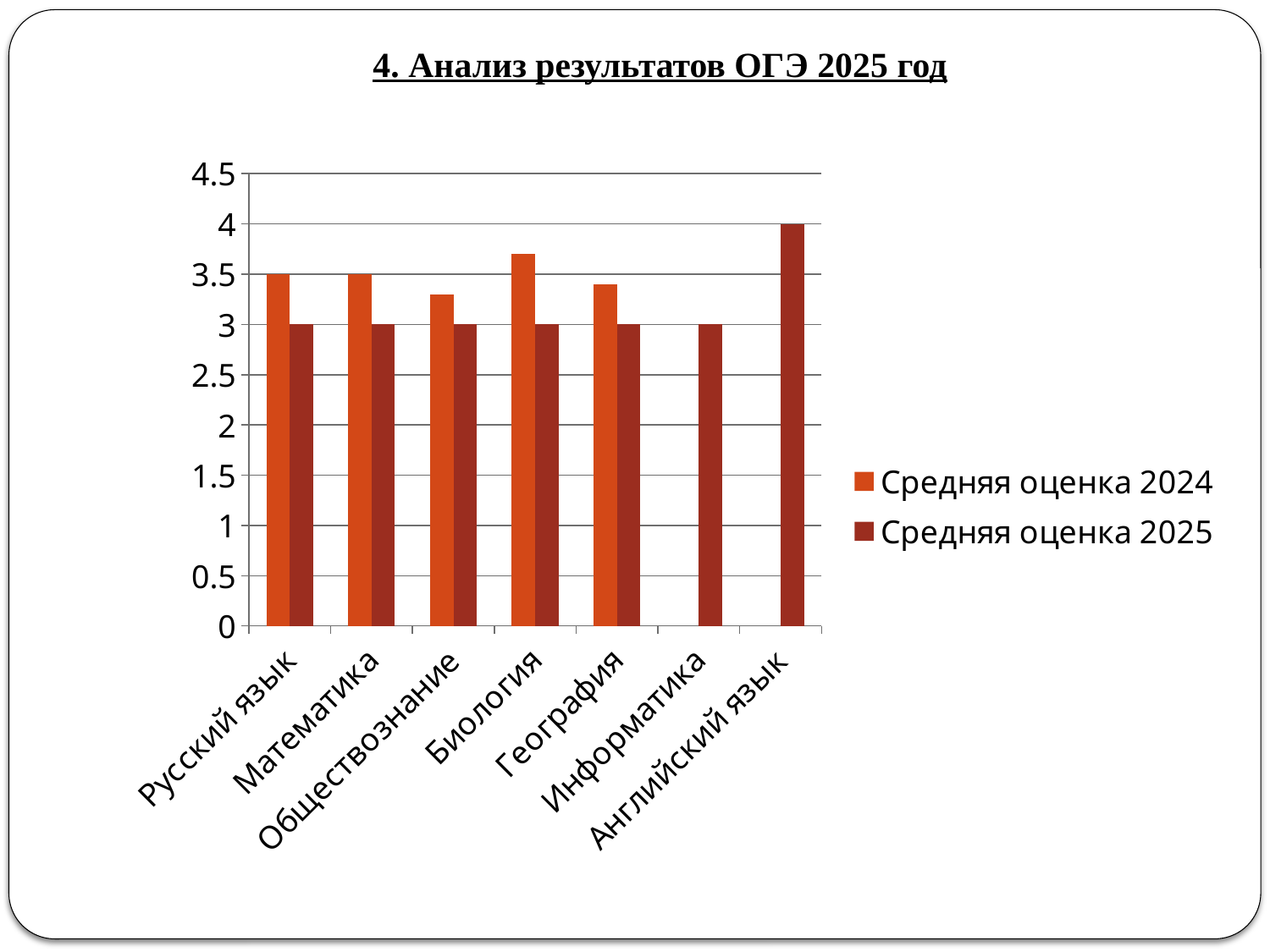
What is the difference between Средняя оценка 2025 for Английский язык and for Информатика? 1 Which subject has the highest Средняя оценка 2025? Английский язык How many series does the legend list? 2 For Русский язык, which is larger: Средняя оценка 2024 or Средняя оценка 2025? Средняя оценка 2024 What kind of chart is shown on the slide? bar chart What is the value of Средняя оценка 2025 for Русский язык? 3 Which subject has the highest Средняя оценка 2024? Биология What is the value of Средняя оценка 2024 for Математика? 3.5 What is the value of Средняя оценка 2025 for Английский язык? 4 How many subjects are shown on the x axis? 7 Is the value of Средняя оценка 2024 for Обществознание greater or less than 3.5? less Is the value of Средняя оценка 2024 for Биология greater or less than 3.5? greater